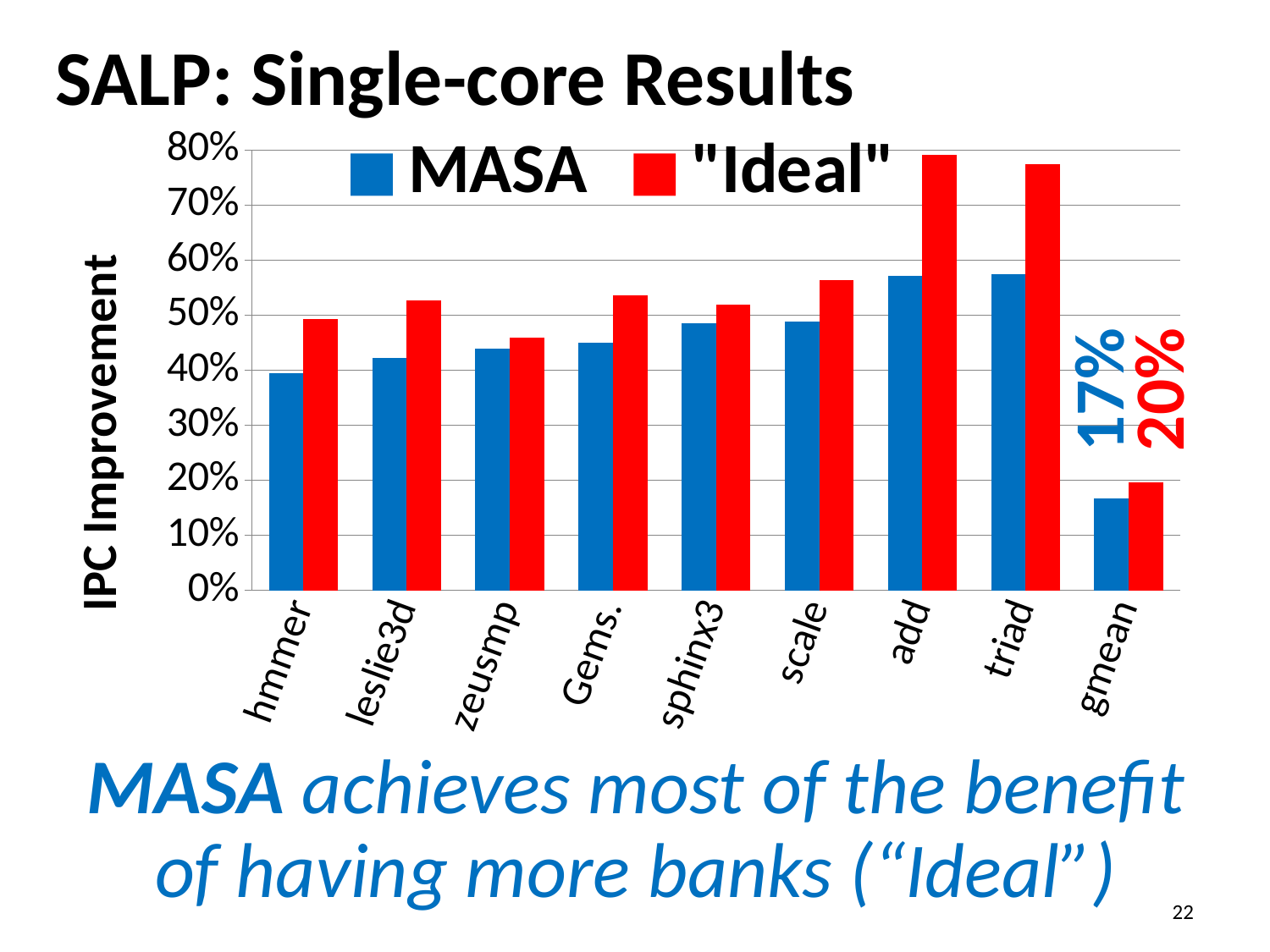
What is the "Ideal" value for gmean? 20% What kind of chart is shown on the slide? bar chart What is the label on the y axis? IPC Improvement Is the "Ideal" value for add greater or less than 70%? greater For hmmer, which is larger: the MASA value or the "Ideal" value? "Ideal" What is the MASA value for gmean? 17% Is the MASA value for hmmer greater or less than 50%? less How many categories are shown on the x axis? 9 Which category has the lowest MASA value? gmean What colour represents the MASA series? blue What is the difference between the "Ideal" and MASA values for gmean? 3% How many series does the legend list? 2